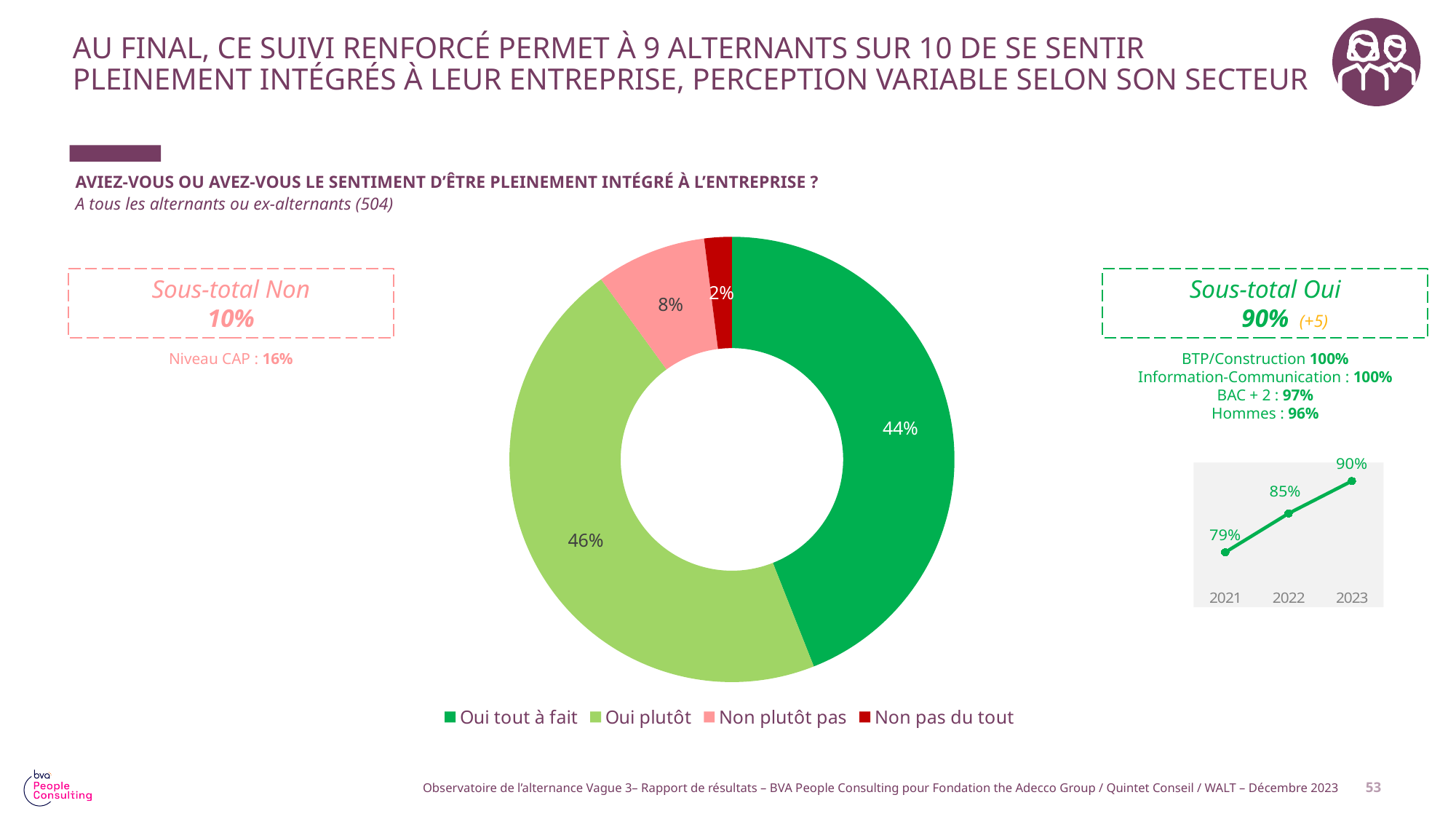
In the donut chart, what percentage of respondents answered "Non pas du tout"? 2% In the small line chart on the right, do the values rise or fall from 2021 to 2023? Rise In the donut chart, which response category has the smallest share? Non pas du tout In the small line chart on the right, what is the difference between the 2023 and 2021 values? 11 percentage points In the donut chart, what percentage of respondents answered "Oui plutôt"? 46% What type of chart is the large chart in the centre of the slide? Donut (pie) chart In the small line chart on the right, what is the value for 2021? 79% In the donut chart, which response category has the largest share? Oui plutôt In the donut chart, which is larger: "Non plutôt pas" or "Non pas du tout"? Non plutôt pas In the small line chart on the right, what is the value for 2022? 85% How many categories does the legend of the donut chart list? 4 In the donut chart, what is the difference between the "Oui plutôt" and "Oui tout à fait" shares? 2 percentage points